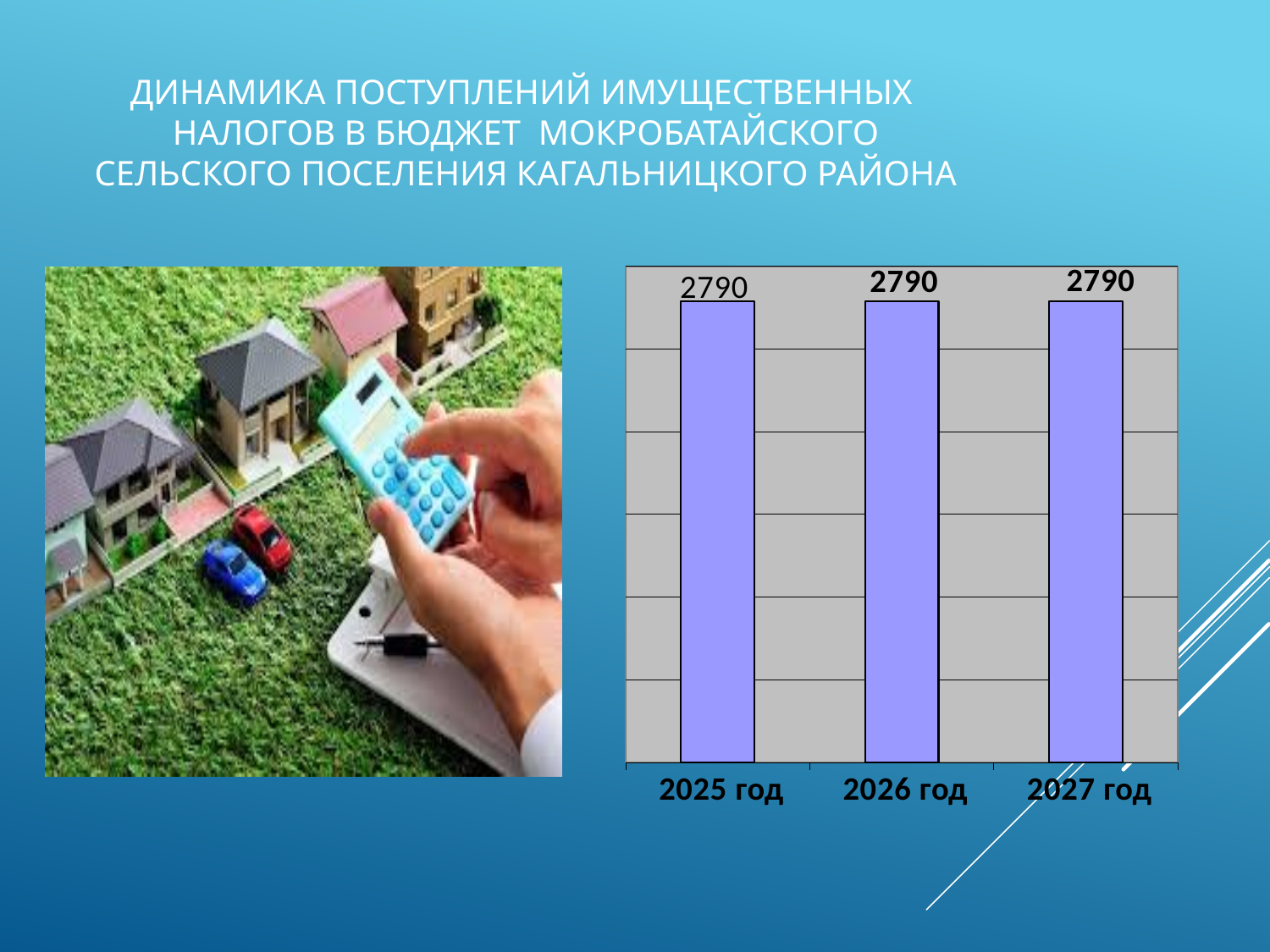
What is the value for 2026 год? 2790 Which years are shown on the x axis of the chart? 2025 год, 2026 год, 2027 год Do the values rise, fall, or stay the same from 2025 год to 2027 год? Stay the same What is the value for 2027 год? 2790 What is the difference between the values for 2027 год and 2025 год? 0 What is the value for 2025 год? 2790 Is the value for 2026 год larger than, smaller than, or equal to the value for 2025 год? Equal How many bars (categories) are shown in the chart? 3 What colour are the bars in the chart? Light purple (blue-violet) What kind of chart is shown on the slide? Bar chart